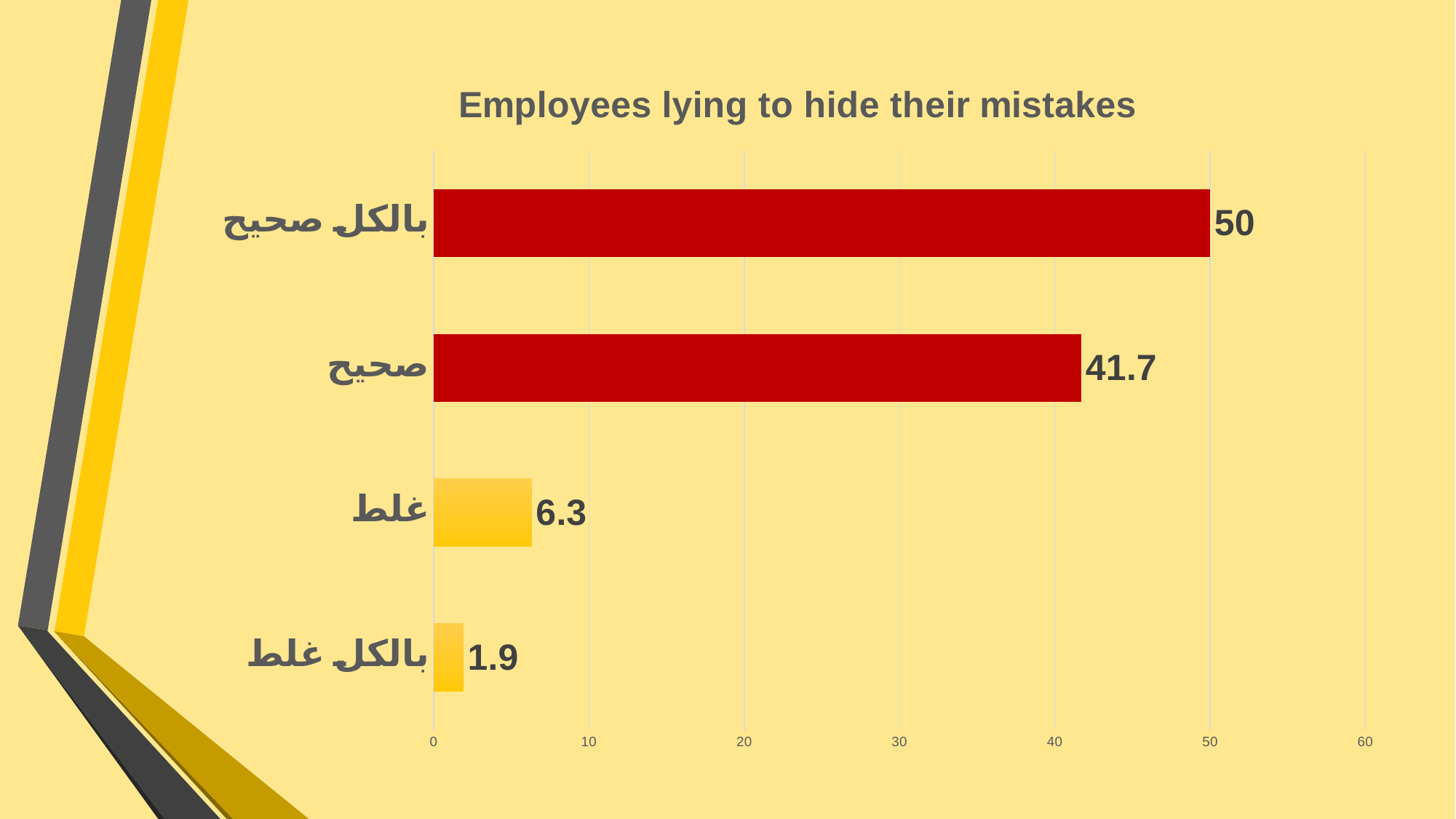
What is the difference between the values for غلط and بالكل غلط? 4.4 Which category has the highest value? بالكل صحيح What is the value for بالكل غلط? 1.9 What is the value for بالكل صحيح? 50 What is the value for غلط? 6.3 Which category has the lowest value? بالكل غلط What is the value for صحيح? 41.7 Which is larger, the value for صحيح or the value for غلط? صحيح What is the title of the chart? Employees lying to hide their mistakes What kind of chart is shown on the slide? bar chart What is the difference between the values for بالكل صحيح and صحيح? 8.3 How many categories are shown in the chart? 4